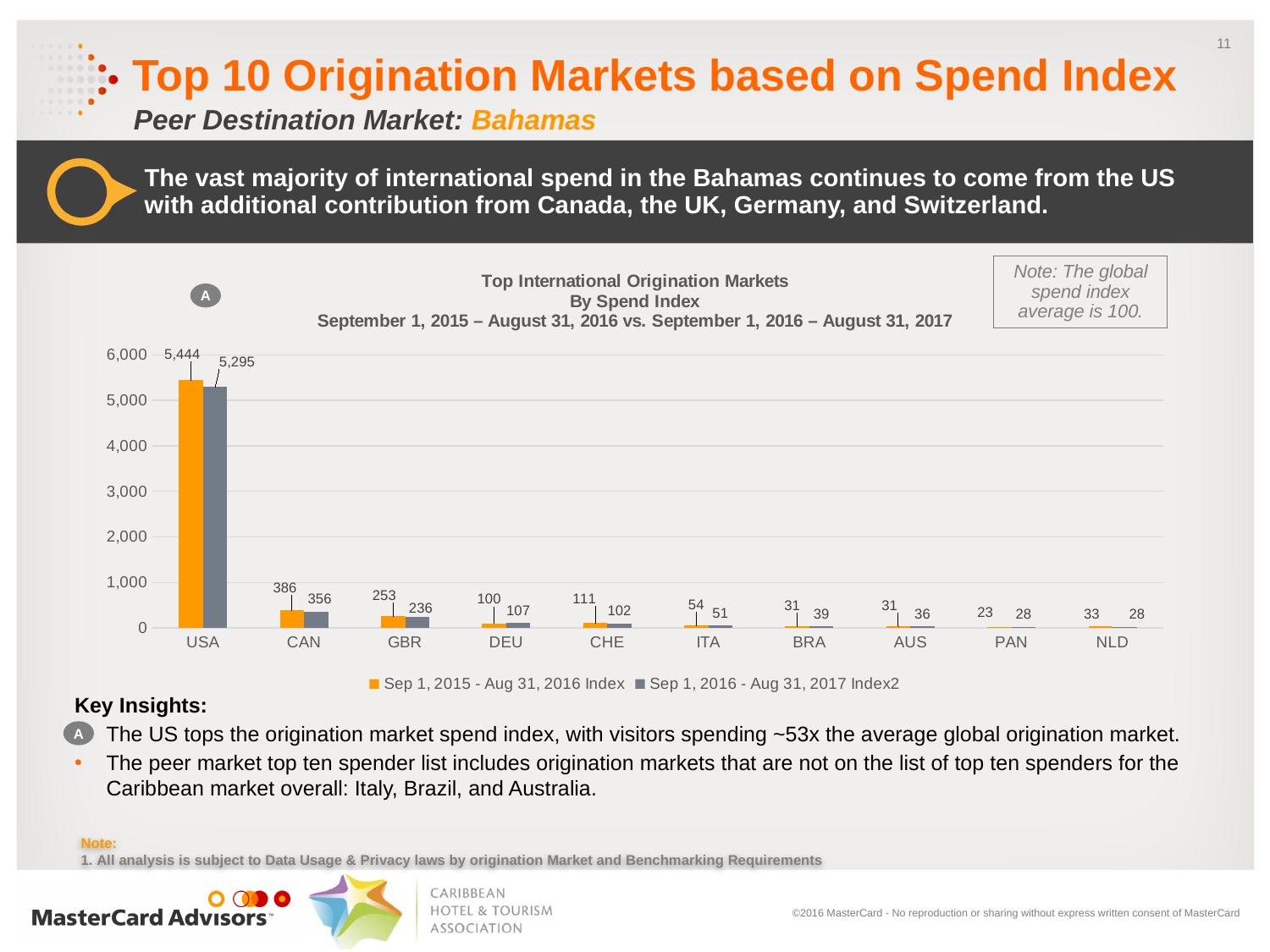
What is the difference between the USA's Sep 1, 2015 - Aug 31, 2016 Index and its Sep 1, 2016 - Aug 31, 2017 Index2? 149 What kind of chart is shown on the slide? Bar chart How many series does the chart legend list? 2 What is the Sep 1, 2015 - Aug 31, 2016 Index value for USA? 5,444 For GBR, which is larger: the Sep 1, 2015 - Aug 31, 2016 Index or the Sep 1, 2016 - Aug 31, 2017 Index2? Sep 1, 2015 - Aug 31, 2016 Index How many origination markets are shown on the x axis of the chart? 10 What is the Sep 1, 2016 - Aug 31, 2017 Index2 value for CAN? 356 Is the Sep 1, 2016 - Aug 31, 2017 Index2 value for USA greater or less than 5,000? greater What is the Sep 1, 2016 - Aug 31, 2017 Index2 value for DEU? 107 Which origination market has the highest Sep 1, 2015 - Aug 31, 2016 Index value? USA Which origination market has the lowest Sep 1, 2015 - Aug 31, 2016 Index value? PAN What is the Sep 1, 2015 - Aug 31, 2016 Index value for NLD? 33